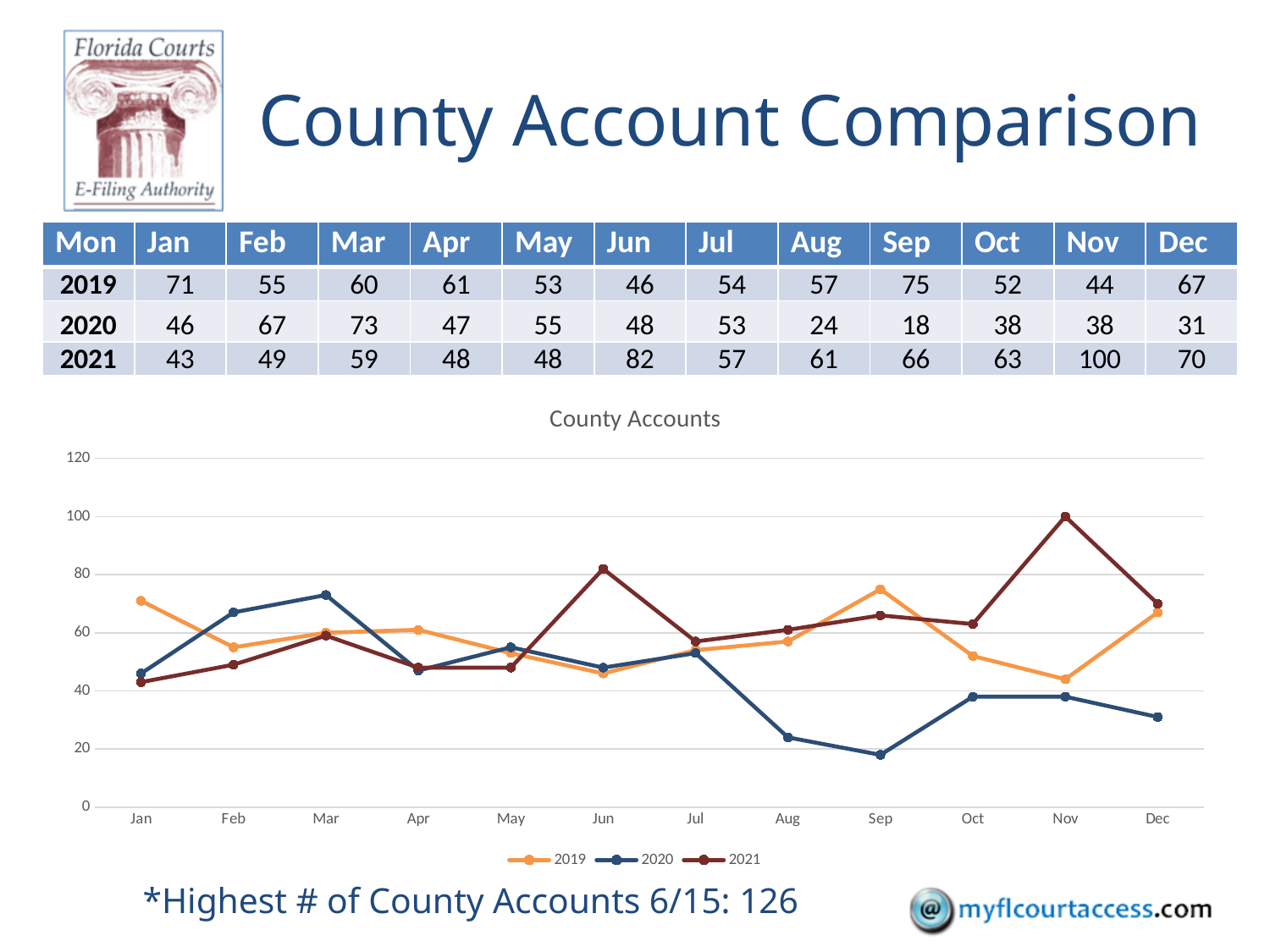
What kind of chart is shown on the slide? line chart Does the 2020 series rise or fall from Jul to Sep? fall What is the value for 2021 in Nov? 100 In which month does the 2020 series reach its lowest value? Sep What is the value for 2019 in Jan? 71 How many months are plotted along the x axis of the County Accounts chart? 12 How many series does the legend of the County Accounts chart list? 3 What is the value for 2020 in Sep? 18 In which month does the 2021 series reach its highest value? Nov What is the difference between the 2021 and 2019 values in Nov? 56 Which series has the larger value in Jun, 2019 or 2021? 2021 Is the value for 2020 in Aug greater or less than 40? less